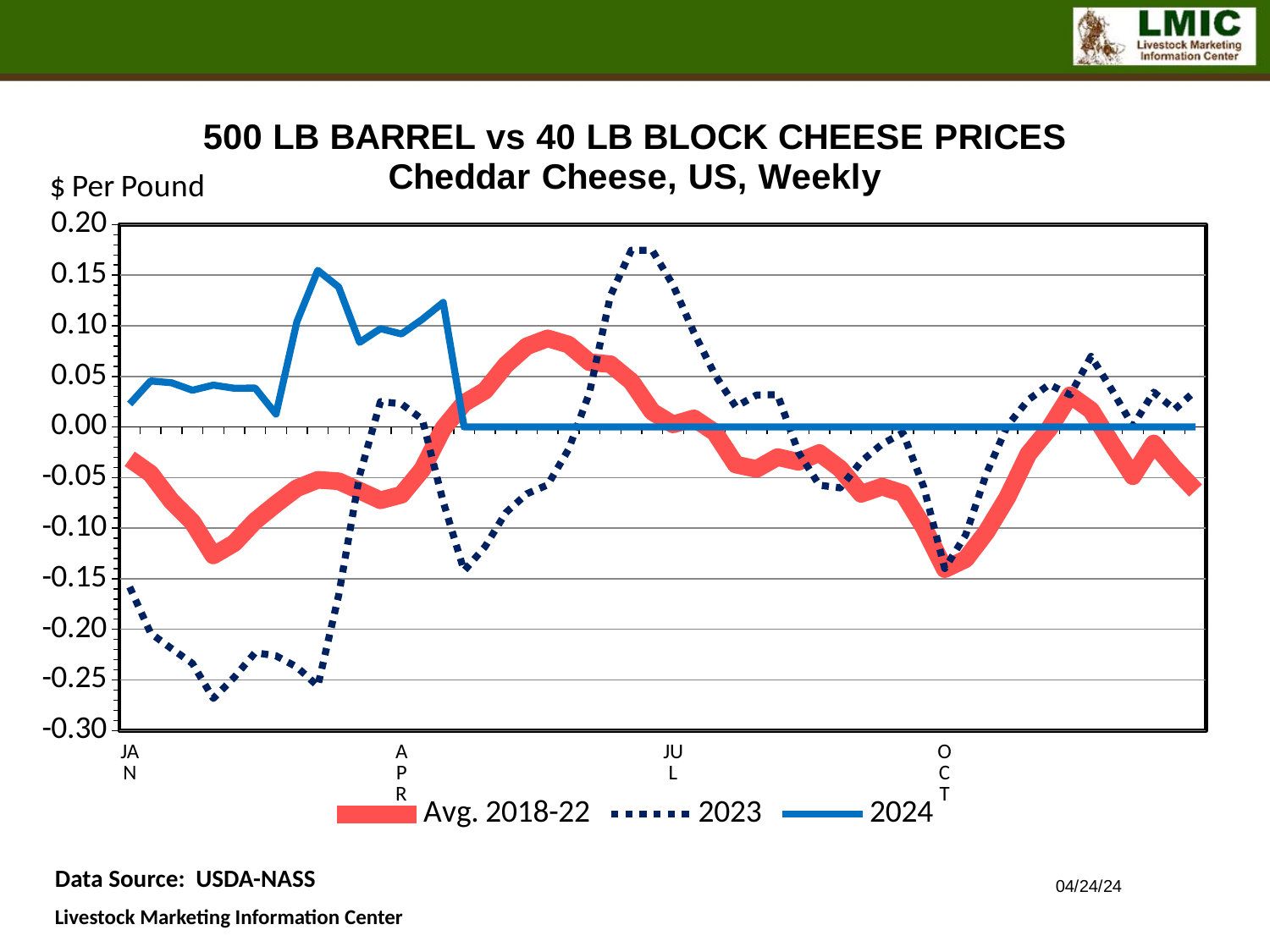
What is the unit label shown on the y axis? $ Per Pound How many series does the legend list? 3 Is the 2023 value at JAN greater or less than -0.10? less Does the 2023 series rise or fall between JAN and APR? Rise Is the lowest point of the 2023 series greater or less than -0.25? less Is the Avg. 2018-22 value at JAN greater or less than 0.00? less At JAN, which is higher: the 2024 series or the Avg. 2018-22 series? 2024 What kind of chart is shown on the slide? Line chart Which series reaches the lowest value on the chart? 2023 What are the three series named in the legend? Avg. 2018-22, 2023, 2024